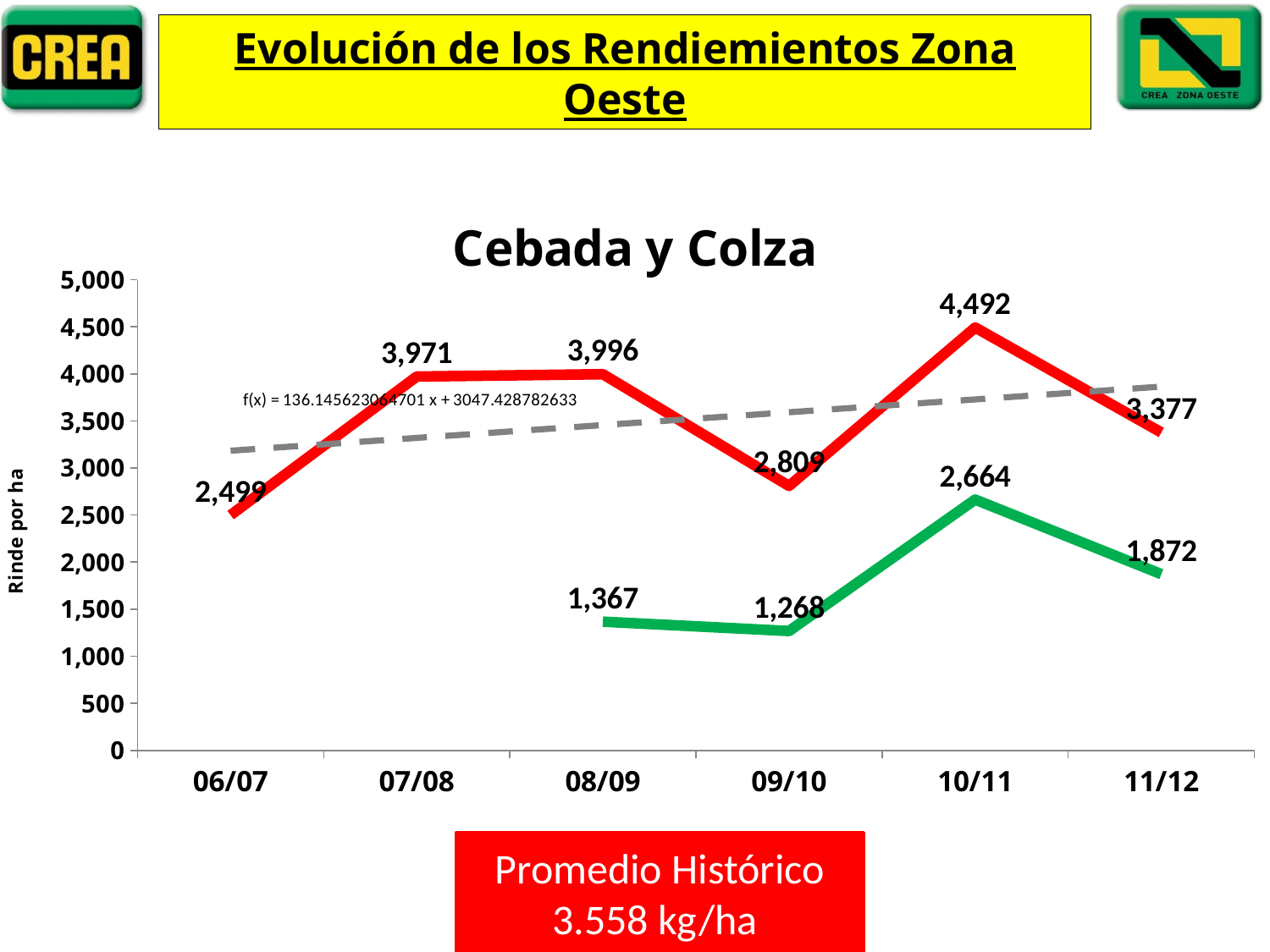
What is the value of the green line for 09/10? 1,268 How many seasons are shown on the x axis? 6 In which season does the green line have its lowest value? 09/10 What is the value of the red line for 10/11? 4,492 What is the title of the chart? Cebada y Colza What is the label of the y axis? Rinde por ha What type of chart is shown? Line chart What is the difference between the red line and the green line in 11/12? 1,505 Which is larger for the red line: the value in 07/08 or the value in 09/10? 07/08 Does the red line rise or fall from 10/11 to 11/12? Fall In which season does the red line reach its highest value? 10/11 What is the value of the red line for 06/07? 2,499